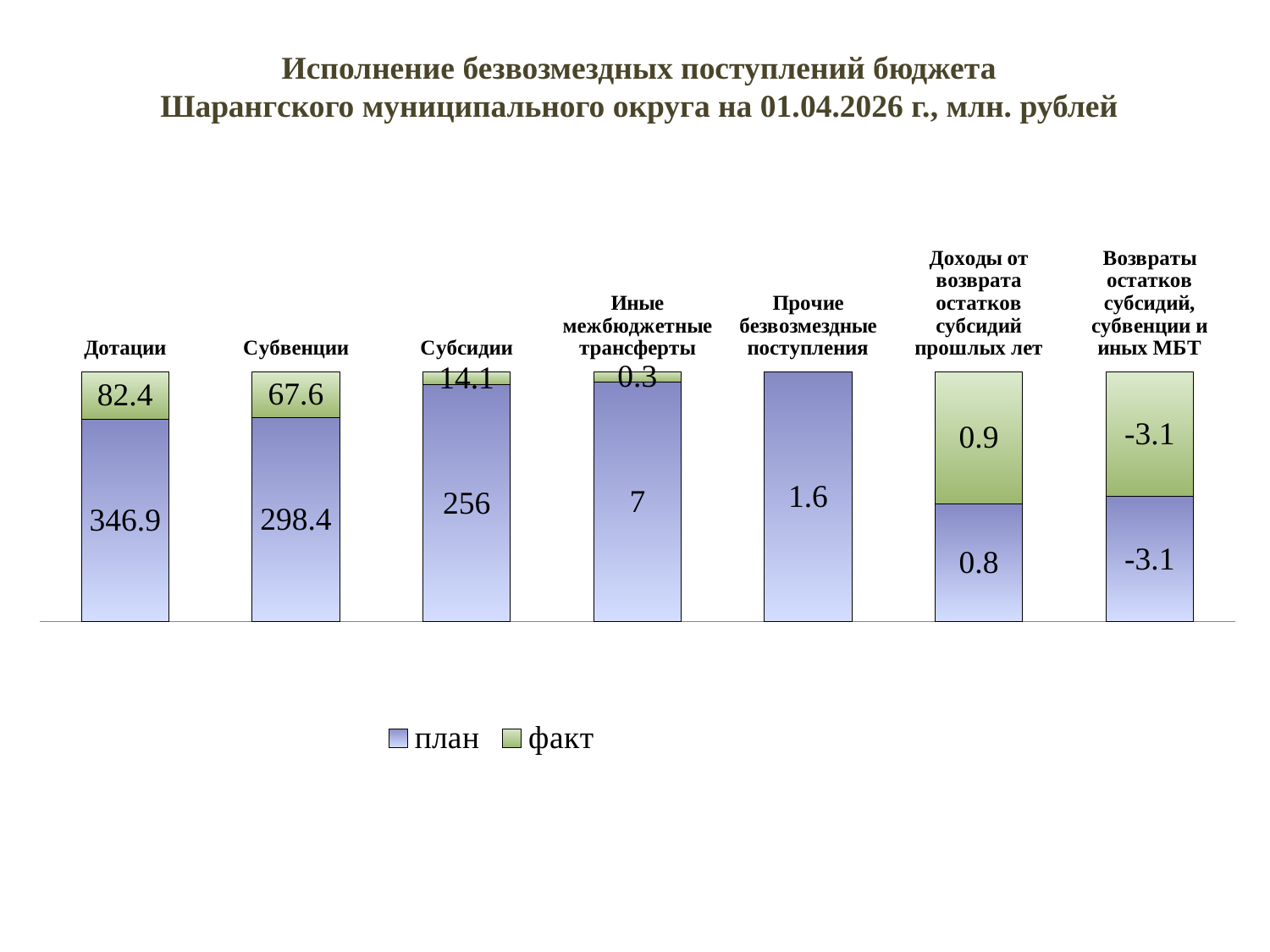
What is the план value for Иные межбюджетные трансферты? 7 What is the план value for Прочие безвозмездные поступления? 1.6 Which category has the highest план value? Дотации What kind of chart is shown on the slide? Stacked bar chart Which is larger, the факт value for Дотации or the факт value for Субвенции? Дотации How many categories are shown on the x axis? 7 What is the факт value for Субсидии? 14.1 What is the факт value for Доходы от возврата остатков субсидий прошлых лет? 0.9 What is the difference between the план and факт values for Дотации? 264.5 How many series does the legend list? 2 What is the план value for Дотации? 346.9 What is the факт value for Субвенции? 67.6